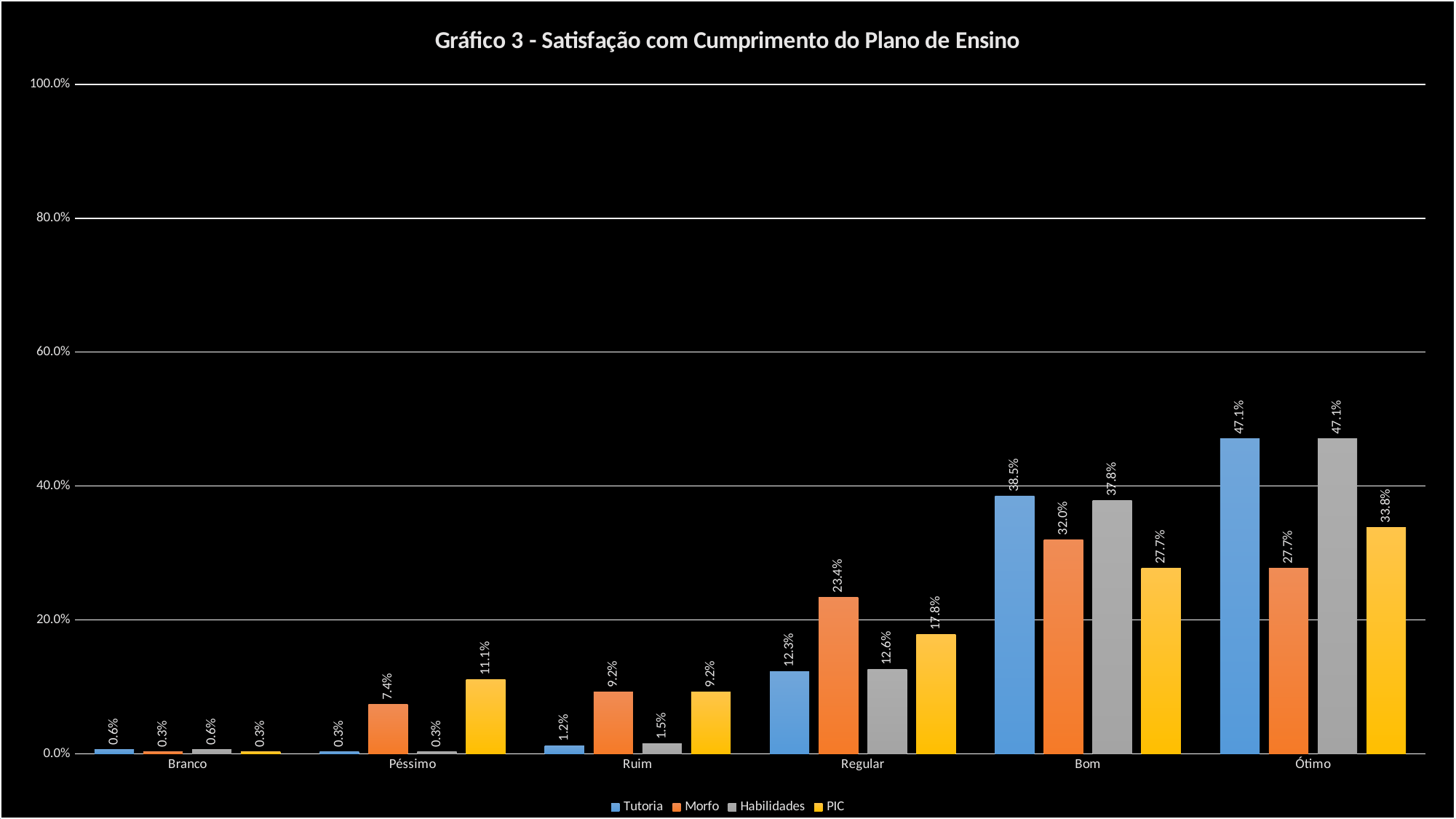
What is the value for PIC in the Péssimo category? 11.1% Which series has the lowest value in the Bom category? PIC What is the difference between the Tutoria and Morfo values in the Ótimo category? 19.4% What is the title of the chart? Gráfico 3 - Satisfação com Cumprimento do Plano de Ensino In the Regular category, which is larger: the value for PIC or the value for Habilidades? PIC What is the value for Morfo in the Regular category? 23.4% What is the value for Habilidades in the Bom category? 37.8% How many series does the legend list? 4 What is the value for Tutoria in the Ótimo category? 47.1% Which category has the highest value for the Morfo series? Bom How many categories are shown on the x axis? 6 What kind of chart is shown on the slide? Bar chart